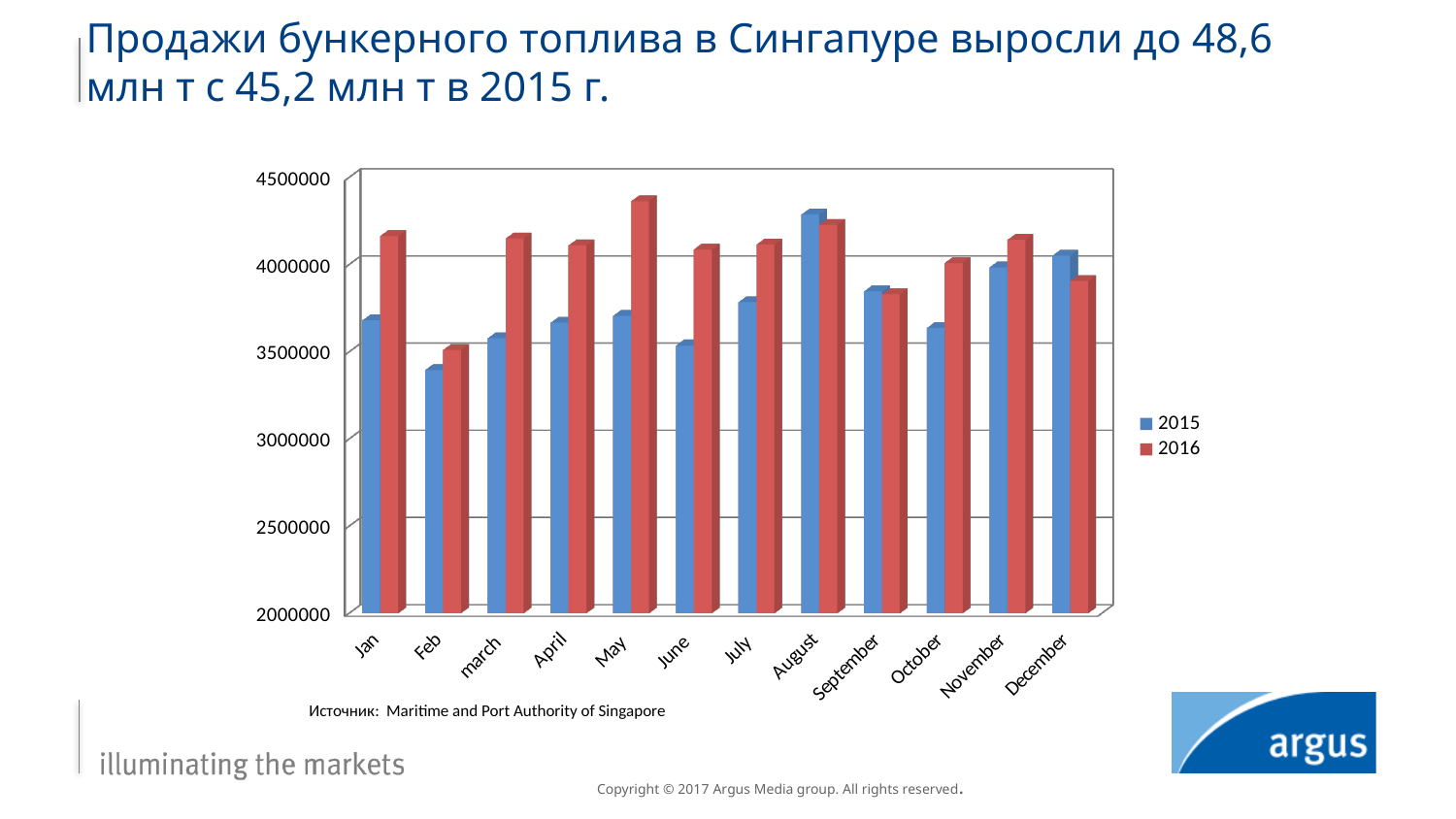
How many series does the legend list? 2 Is the value for Feb in the 2015 series greater or less than 3500000? less Is the value for October in the 2015 series greater or less than 4000000? less Is the value for Jan in the 2016 series greater or less than 4000000? greater What kind of chart is shown on the slide? bar chart How many months are shown on the x axis? 12 Which month has the highest value for the 2015 series? August In December, which series has the larger value, 2015 or 2016? 2015 What are the two entries listed in the legend? 2015 and 2016 In March, which series has the larger value, 2015 or 2016? 2016 Which month has the lowest value for the 2015 series? Feb Which month has the highest value for the 2016 series? May